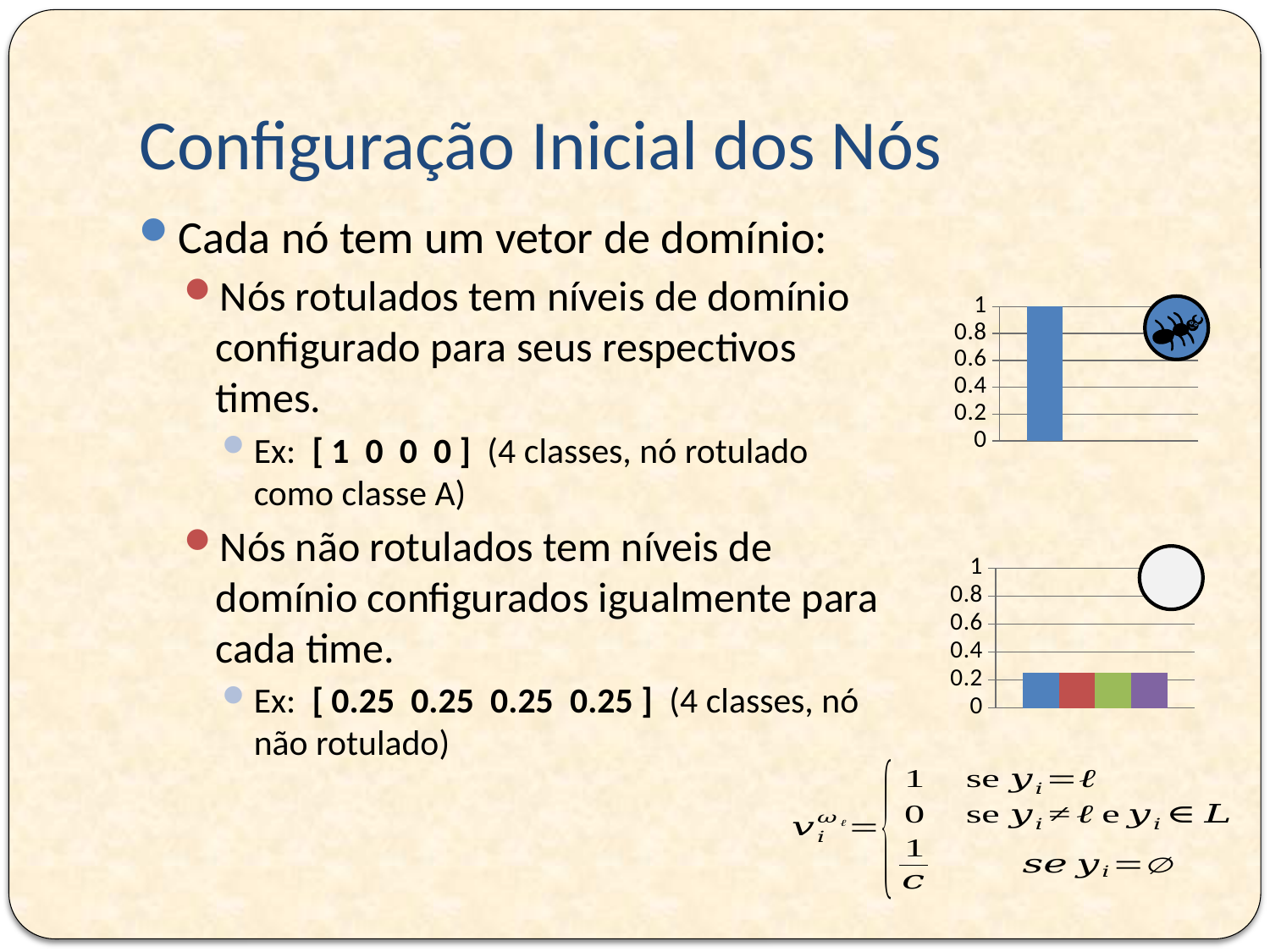
In the upper chart, what value does the single bar reach? 1 What kind of chart is the lower chart on the right side of the slide? bar chart In the lower chart, is the value of the last (purple) bar greater or less than 0.6? less What is the highest tick value shown on the vertical axis of the upper chart? 1 How many bars are plotted in the upper chart? 1 What kind of chart is the upper chart on the right side of the slide? bar chart How many bars are plotted in the lower chart? 4 What colour is the bar in the upper chart? blue In the upper chart, is the value of the bar greater or less than 0.8? greater In the lower chart, is the value of the first (blue) bar greater or less than 0.4? less